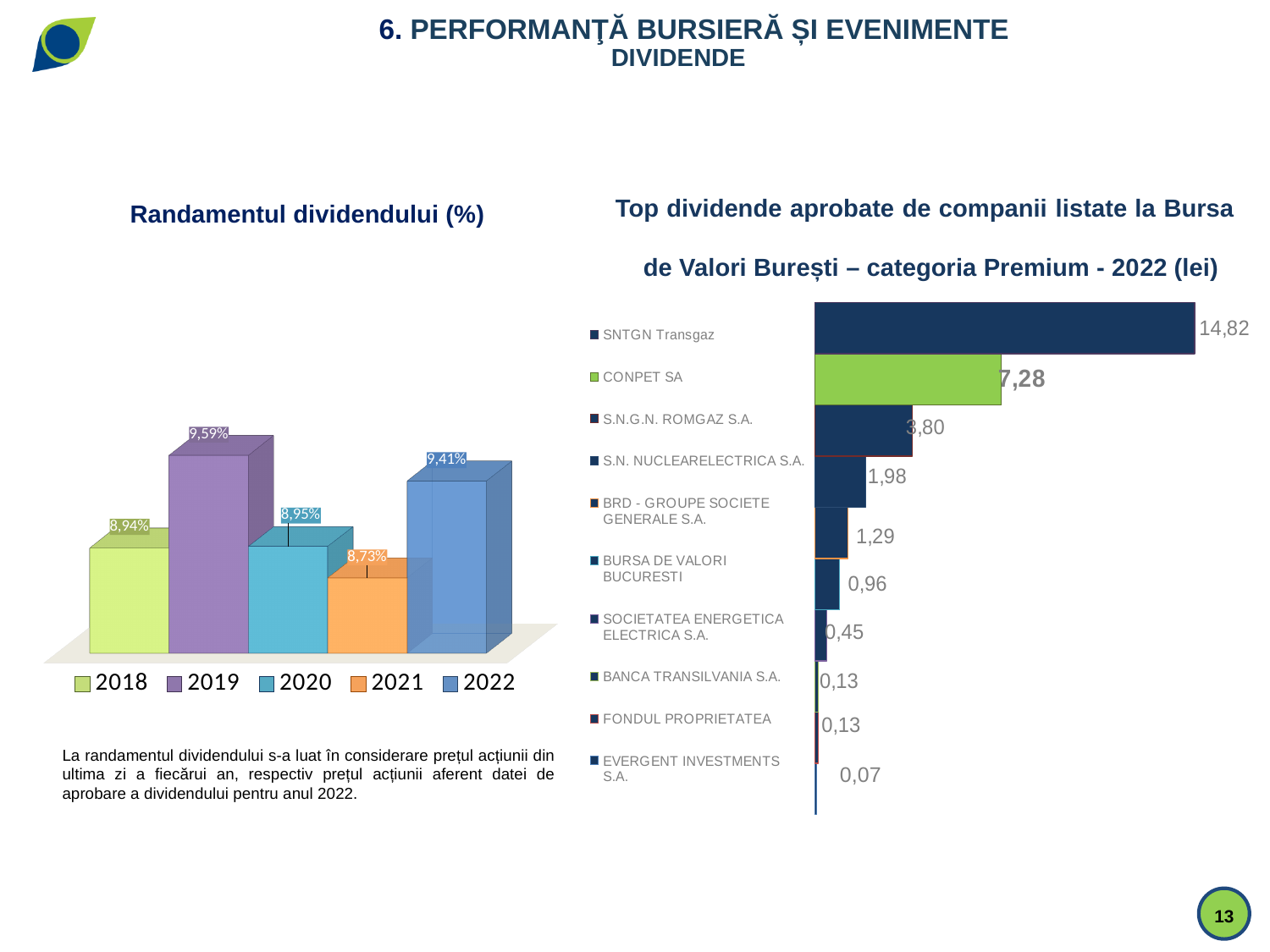
In the 'Top dividende aprobate' chart, what is the value for SNTGN Transgaz? 14,82 In the 'Randamentul dividendului (%)' chart, which year has the highest dividend yield? 2019 In the 'Randamentul dividendului (%)' chart, which year has the lowest dividend yield? 2021 In the 'Top dividende aprobate' chart, what is the value for S.N. NUCLEARELECTRICA S.A.? 1,98 What type of chart is the 'Top dividende aprobate' chart? Bar chart In the 'Top dividende aprobate' chart, which company has the lowest approved dividend? EVERGENT INVESTMENTS S.A. In the 'Randamentul dividendului (%)' chart, what is the value for 2021? 8,73% In the 'Randamentul dividendului (%)' chart, what is the difference between the 2019 and 2021 values? 0,86% In the 'Randamentul dividendului (%)' chart, what is the value for 2019? 9,59% In the 'Top dividende aprobate' chart, what is the difference between SNTGN Transgaz and CONPET SA? 7,54 In the 'Randamentul dividendului (%)' chart, how many years are shown in the legend? 5 In the 'Top dividende aprobate' chart, how many companies are listed? 10